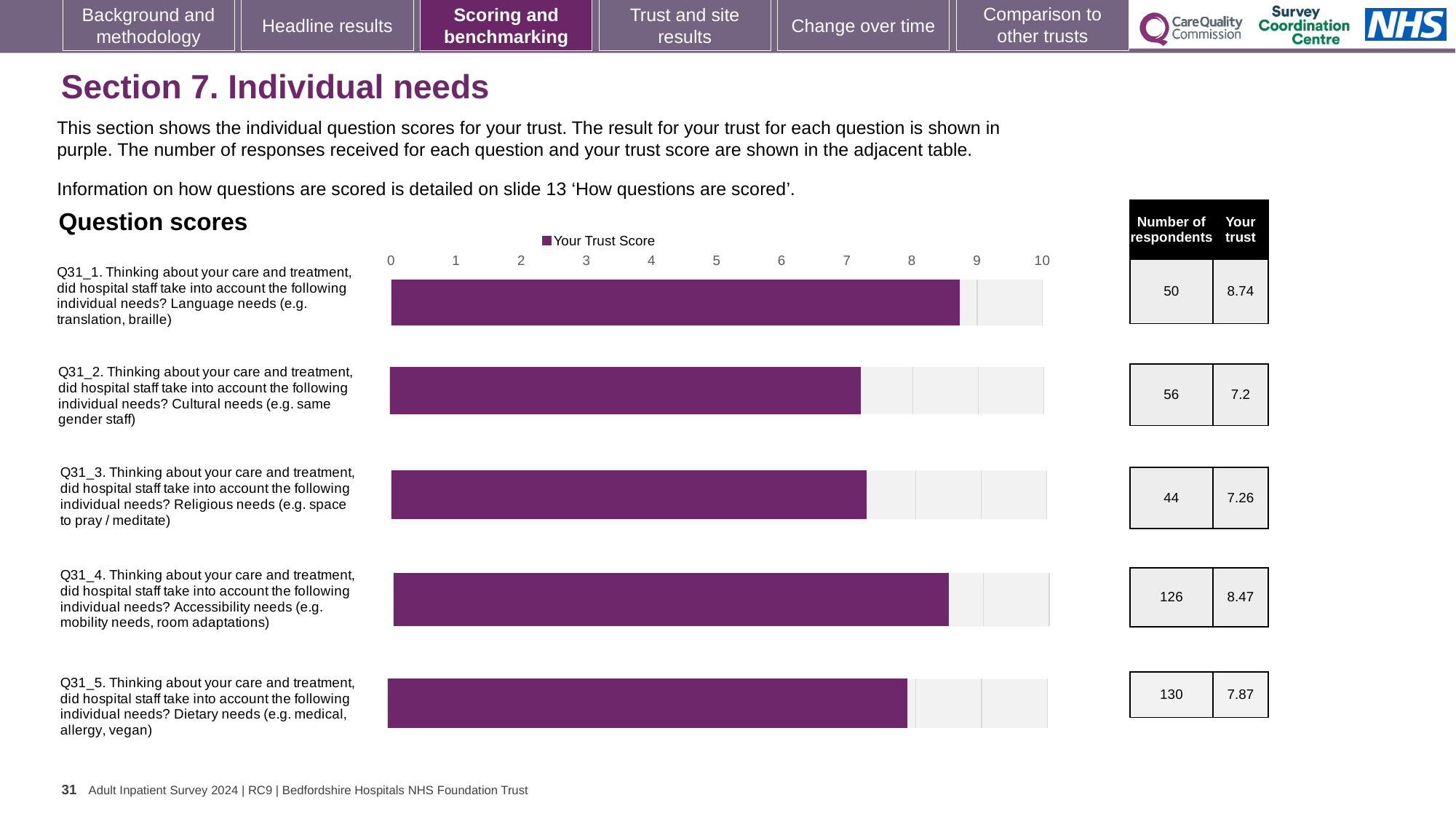
Which question has the highest trust score? Q31_1 How many questions are plotted in the chart? 5 What type of chart is shown on the slide? bar chart How many respondents answered Q31_4 (Accessibility needs)? 126 What is the trust score for Q31_1 (Language needs)? 8.74 How many series does the chart legend list? 1 What is the trust score for Q31_5 (Dietary needs)? 7.87 Which question has the lowest trust score? Q31_2 Is the trust score for Q31_3 (Religious needs) greater or less than 8? less What is the name of the series shown in the chart legend? Your Trust Score What is the difference between the trust scores for Q31_1 and Q31_2? 1.54 Which has a higher trust score, Q31_4 (Accessibility needs) or Q31_5 (Dietary needs)? Q31_4